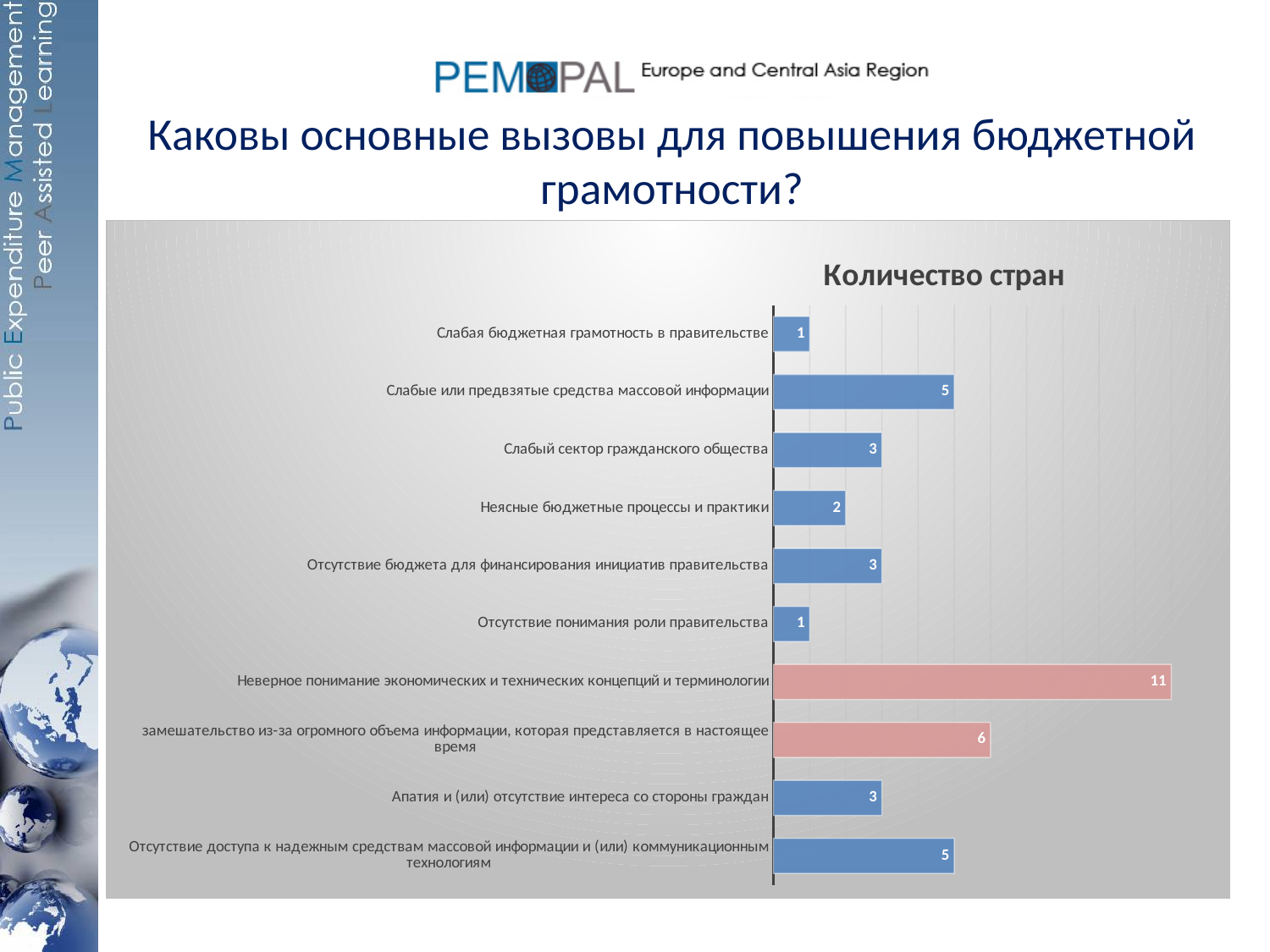
What is the difference between the values for "Неверное понимание экономических и технических концепций и терминологии" and "замешательство из-за огромного объема информации, которая представляется в настоящее время"? 5 Which is larger: the value for "Апатия и (или) отсутствие интереса со стороны граждан" or the value for "Отсутствие доступа к надежным средствам массовой информации и (или) коммуникационным технологиям"? Отсутствие доступа к надежным средствам массовой информации и (или) коммуникационным технологиям What is the value for "Неверное понимание экономических и технических концепций и терминологии"? 11 What kind of chart is shown on the slide? bar chart What is the value for "замешательство из-за огромного объема информации, которая представляется в настоящее время"? 6 How many categories are plotted in the chart? 10 How many bars in the chart are coloured pink/red rather than blue? 2 What is the difference between the values for "Слабые или предвзятые средства массовой информации" and "Неясные бюджетные процессы и практики"? 3 What is the title of the chart? Количество стран What is the value for "Слабые или предвзятые средства массовой информации"? 5 What is the value for "Неясные бюджетные процессы и практики"? 2 Which category has the highest value? Неверное понимание экономических и технических концепций и терминологии